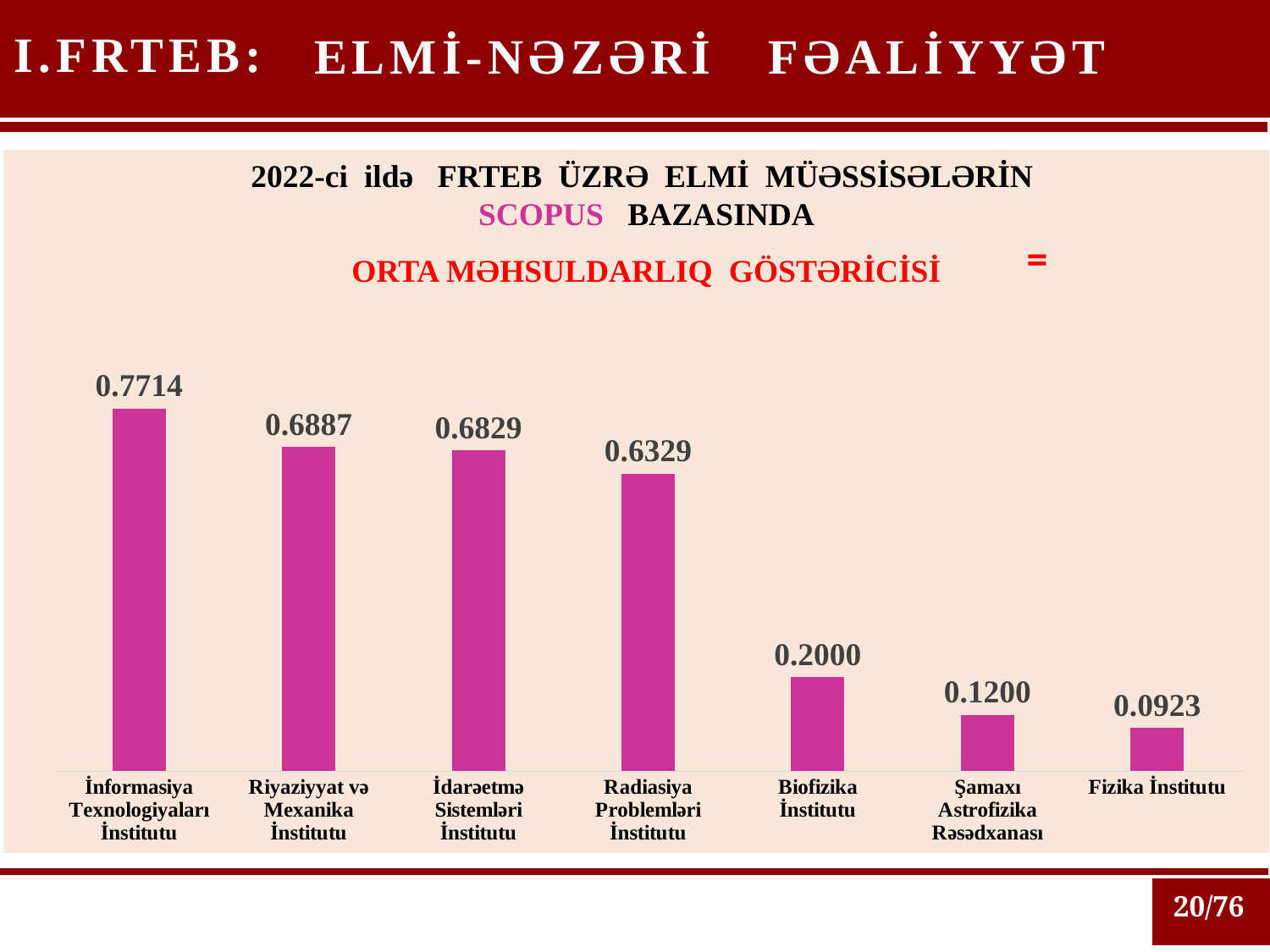
Which institute has the highest value? İnformasiya Texnologiyaları İnstitutu What is the difference between the values for İnformasiya Texnologiyaları İnstitutu and Fizika İnstitutu? 0.6791 What is the value for Şamaxı Astrofizika Rəsədxanası? 0.1200 What is the value for Biofizika İnstitutu? 0.2000 Which institute has the lowest value? Fizika İnstitutu What kind of chart is shown on the slide? Bar chart What is the value for İnformasiya Texnologiyaları İnstitutu? 0.7714 What is the difference between the values for Radiasiya Problemləri İnstitutu and Biofizika İnstitutu? 0.4329 How many institutes are shown in the chart? 7 What colour are the bars in the chart? Magenta Do the values rise or fall from left to right across the chart? Fall Which is larger, the value for Riyaziyyat və Mexanika İnstitutu or the value for Radiasiya Problemləri İnstitutu? Riyaziyyat və Mexanika İnstitutu